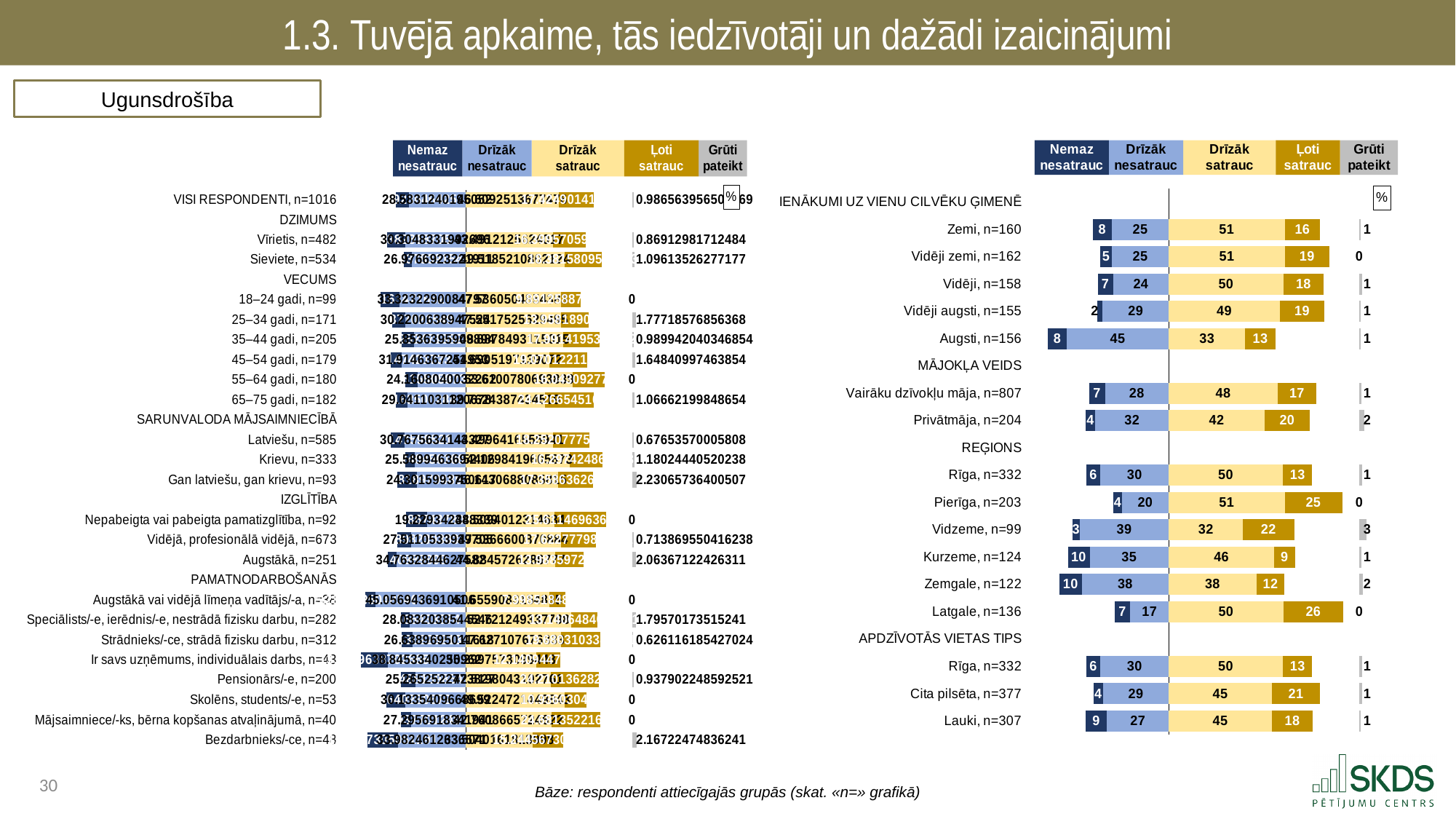
In the right-hand chart, what is the 'Drīzāk nesatrauc' value for Augsti, n=156? 45 In the right-hand chart, what is the 'Nemaz nesatrauc' value for Kurzeme, n=124? 10 In the right-hand chart, which has a larger 'Ļoti satrauc' value: Cita pilsēta, n=377 or Lauki, n=307? Cita pilsēta, n=377 In the right-hand chart, which region under REĢIONS has the lowest 'Drīzāk nesatrauc' value? Latgale, n=136 In the right-hand chart, which region under REĢIONS has the highest 'Ļoti satrauc' value? Latgale, n=136 In the right-hand chart, what is the 'Ļoti satrauc' value for Privātmāja, n=204? 20 In the right-hand chart, what is the total of the stacked bar for Augsti, n=156? 100 What kind of chart is the right-hand chart? Stacked horizontal bar chart How many categories are plotted under APDZĪVOTĀS VIETAS TIPS in the right-hand chart? 3 In the right-hand chart, what is the 'Drīzāk satrauc' value for Zemi, n=160? 51 How many series does the legend of the right-hand chart list? 5 In the right-hand chart, what is the difference between the 'Drīzāk satrauc' values for Pierīga, n=203 and Vidzeme, n=99? 19